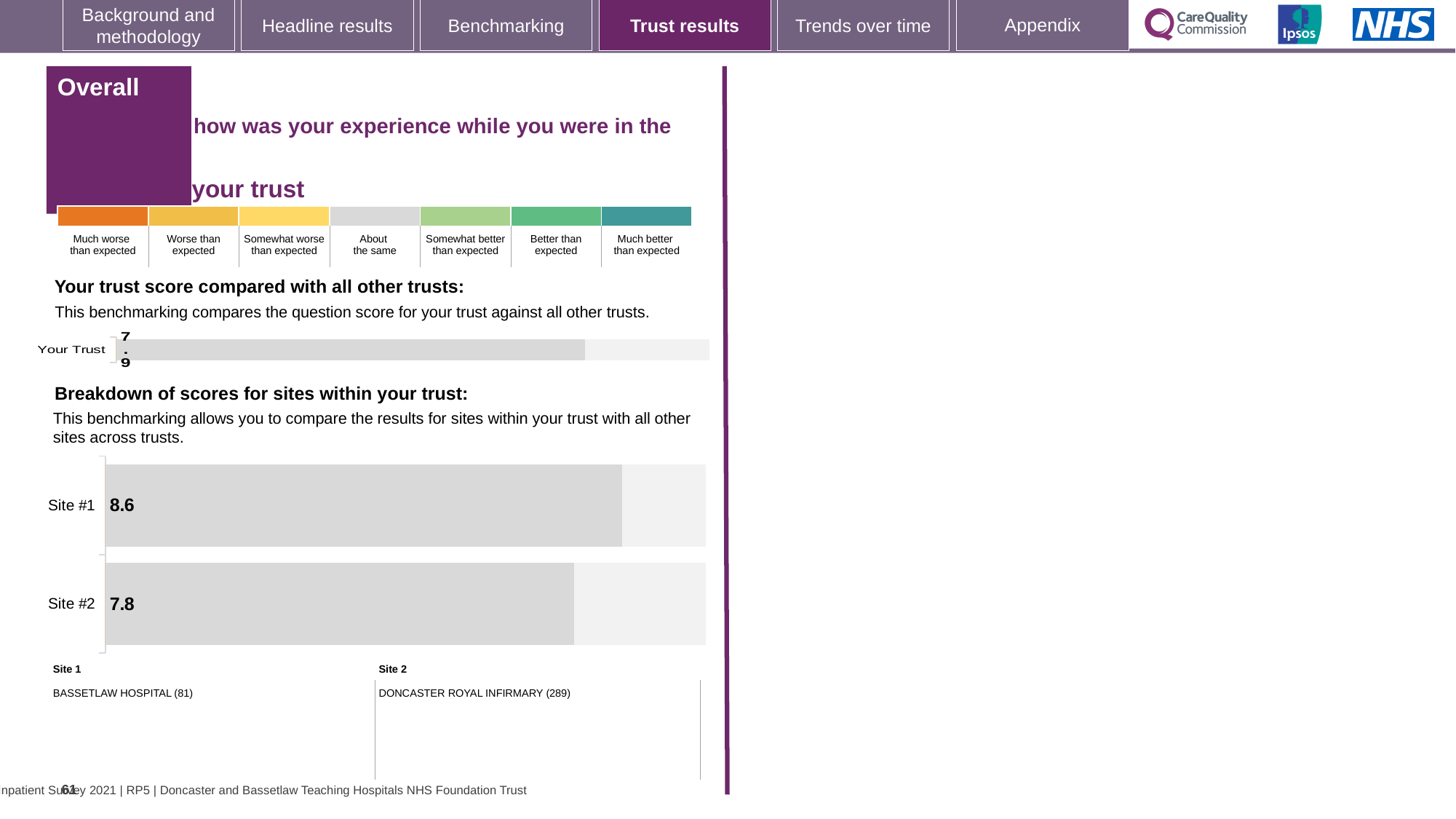
What kind of chart is the 'Breakdown of scores for sites within your trust' chart? Bar chart How many sites are shown in the 'Breakdown of scores for sites within your trust' chart? 2 In the 'Your trust score compared with all other trusts' chart, what is the score shown for Your Trust? 7.9 According to the key below the site chart, which hospital is Site 1? BASSETLAW HOSPITAL (81) In the 'Breakdown of scores for sites within your trust' chart, which site has the lowest score? Site #2 In the 'Breakdown of scores for sites within your trust' chart, what is the score for Site #1? 8.6 In the 'Breakdown of scores for sites within your trust' chart, what is the difference between the scores for Site #1 and Site #2? 0.8 In the 'Breakdown of scores for sites within your trust' chart, what is the score for Site #2? 7.8 According to the key below the site chart, which hospital is Site 2? DONCASTER ROYAL INFIRMARY (289) In the 'Breakdown of scores for sites within your trust' chart, which site has the highest score? Site #1 How many categories are plotted in the 'Your trust score compared with all other trusts' chart? 1 In the 'Breakdown of scores for sites within your trust' chart, is the score for Site #1 or Site #2 larger? Site #1